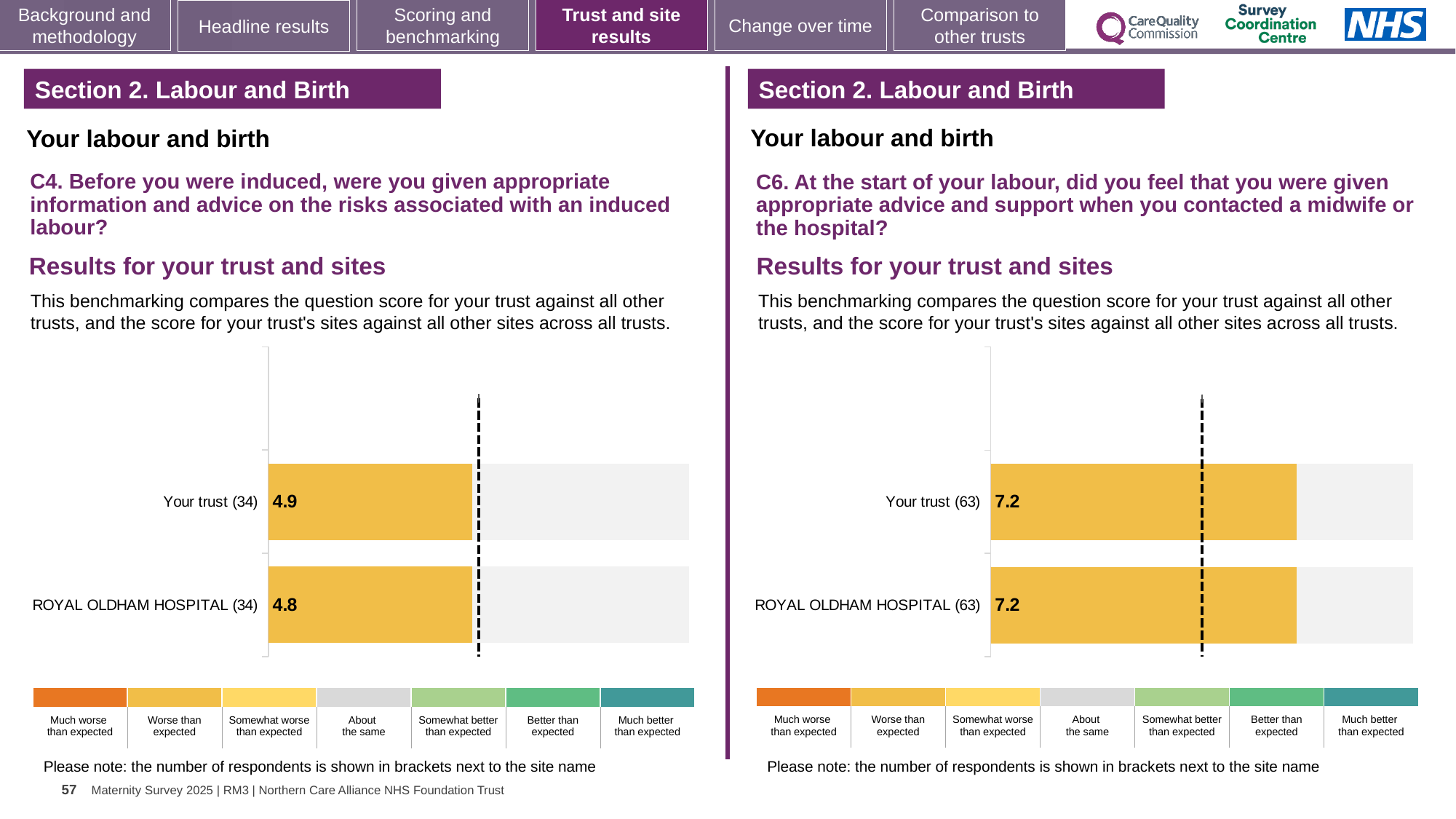
In the C4 chart on the left, what is the score for Your trust (34)? 4.9 In the C6 chart on the right, what is the difference between the Your trust score and the ROYAL OLDHAM HOSPITAL score? 0 In the C6 chart on the right, what is the score for Your trust (63)? 7.2 In the C4 chart on the left, how many respondents are shown in brackets for ROYAL OLDHAM HOSPITAL? 34 In the C6 chart on the right, how many respondents are shown in brackets for Your trust? 63 In the C4 chart on the left, which bar has the higher score, Your trust or ROYAL OLDHAM HOSPITAL? Your trust How many bars are plotted in the C6 chart on the right? 2 In the C4 chart on the left, what is the difference between the Your trust score and the ROYAL OLDHAM HOSPITAL score? 0.1 What type of chart is used in the C6 chart on the right? Bar chart In the C4 chart on the left, what is the score for ROYAL OLDHAM HOSPITAL (34)? 4.8 How many bars are plotted in the C4 chart on the left? 2 In the C6 chart on the right, what is the score for ROYAL OLDHAM HOSPITAL (63)? 7.2